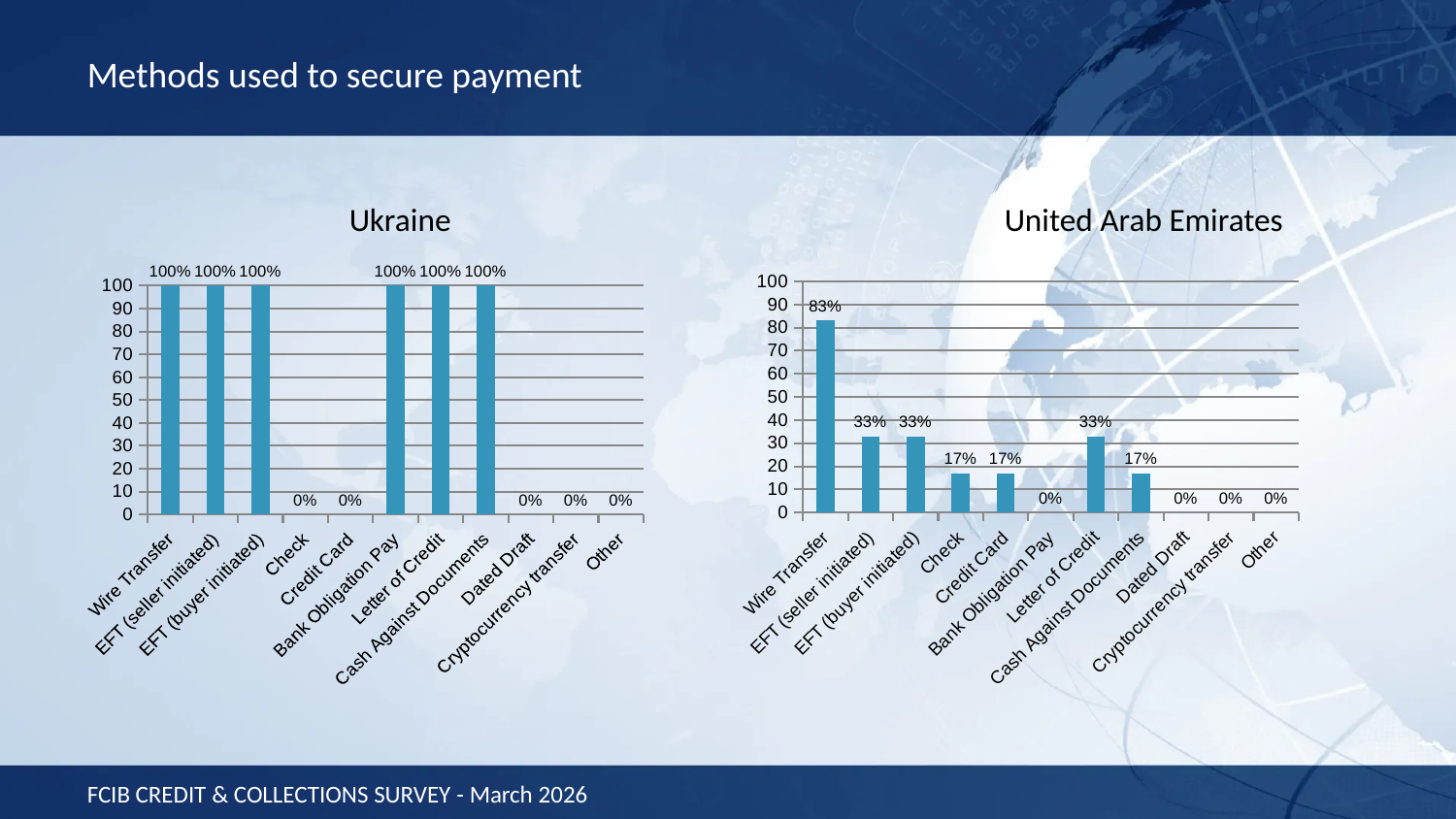
How many categories are shown in the Ukraine chart? 11 What kind of chart is the Ukraine chart? Bar chart In the United Arab Emirates chart, which is larger, Check or Letter of Credit? Letter of Credit In the United Arab Emirates chart, is the value for Wire Transfer greater or less than 80? greater In the United Arab Emirates chart, what is the value for Wire Transfer? 83% In the United Arab Emirates chart, what is the value for Letter of Credit? 33% In the United Arab Emirates chart, what is the difference between Wire Transfer and EFT (seller initiated)? 50% What is the title of the chart on the right side of the slide? United Arab Emirates In the United Arab Emirates chart, what is the value for Cash Against Documents? 17% In the United Arab Emirates chart, which category has the highest value? Wire Transfer In the Ukraine chart, what is the value for Bank Obligation Pay? 100% In the Ukraine chart, what is the value for Check? 0%